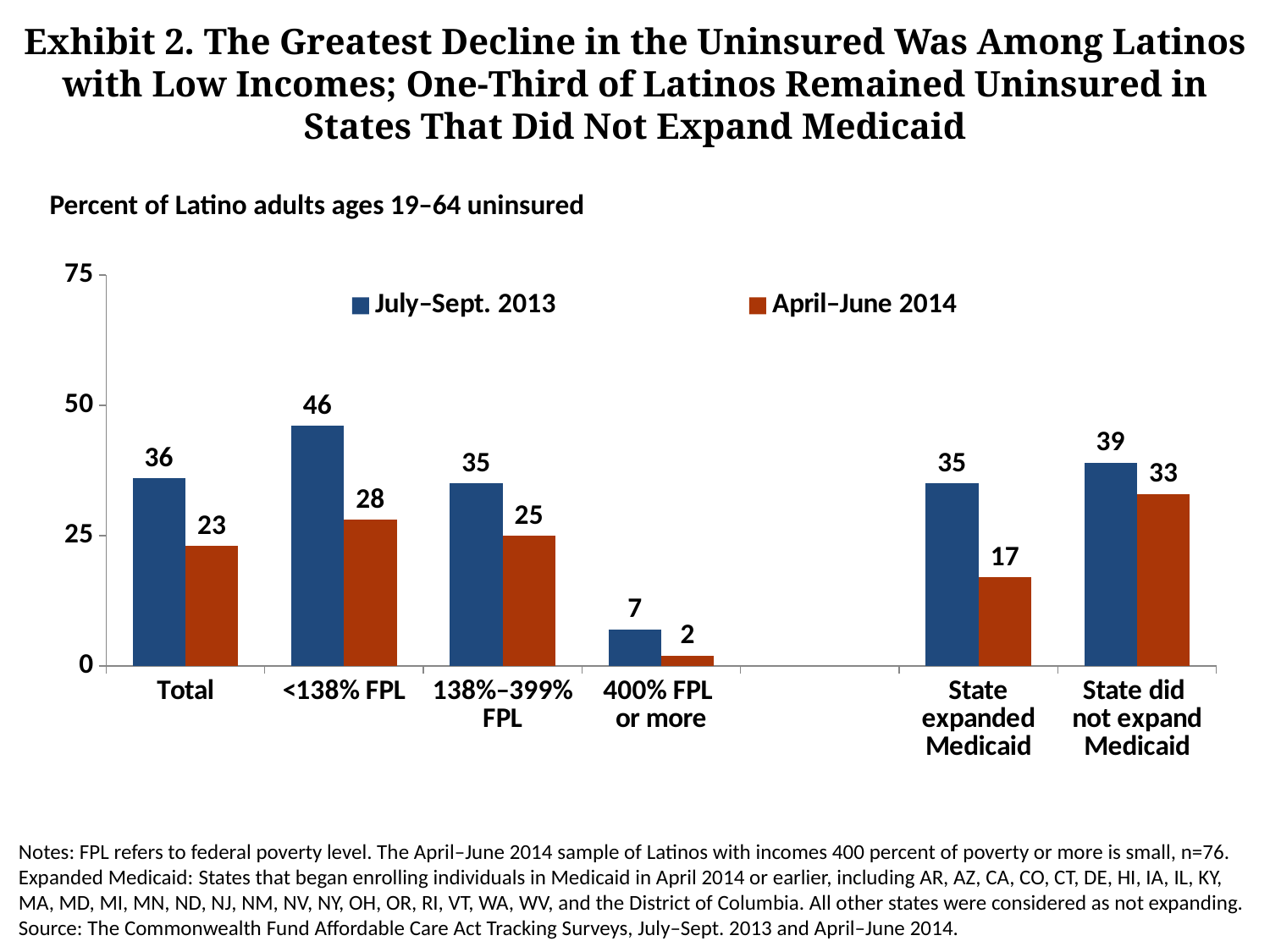
Is the July–Sept. 2013 value for State did not expand Medicaid greater or less than 25? greater Which is larger: the April–June 2014 value for 138%–399% FPL or for State did not expand Medicaid? State did not expand Medicaid What is the April–June 2014 value for <138% FPL? 28 What is the difference between the April–June 2014 values for State did not expand Medicaid and State expanded Medicaid? 16 What is the July–Sept. 2013 value for Total? 36 What kind of chart is shown? bar chart What is the April–June 2014 value for State expanded Medicaid? 17 What is the difference between the July–Sept. 2013 and April–June 2014 values for <138% FPL? 18 How many categories are shown on the x axis? 6 Which category has the lowest April–June 2014 value? 400% FPL or more How many series does the legend list? 2 Which category has the highest July–Sept. 2013 value? <138% FPL